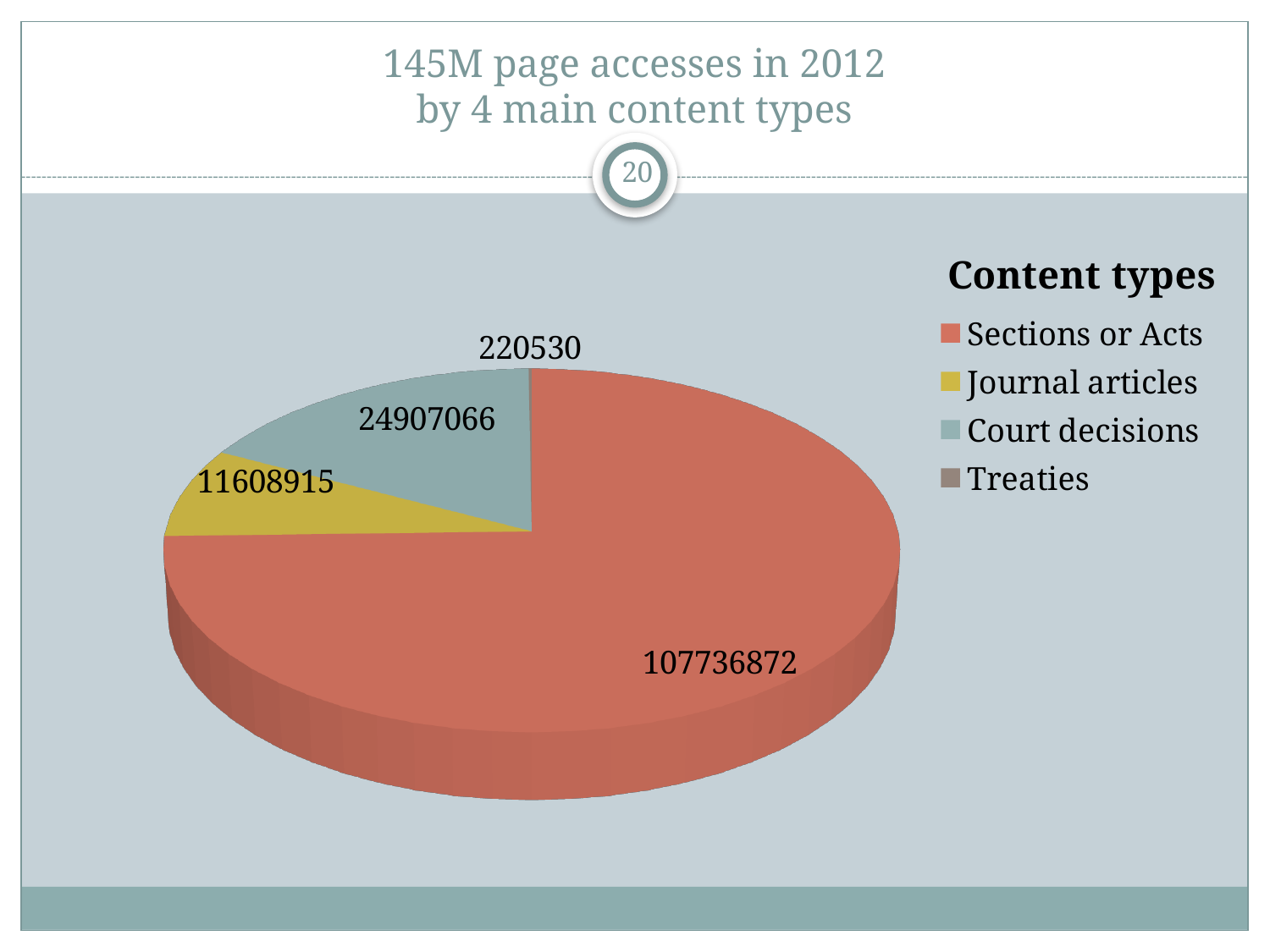
What is the value shown for Court decisions? 24907066 What is the value shown for Journal articles? 11608915 What kind of chart is shown on the slide? pie chart What colour is the slice for Sections or Acts? red What is the value shown for Treaties? 220530 Which content type has the smallest slice of the pie? Treaties What is the title of the chart's legend? Content types How many content types are shown in the pie chart? 4 What is the value shown for Sections or Acts? 107736872 Which is larger, Court decisions or Journal articles? Court decisions Which content type has the largest slice of the pie? Sections or Acts What is the difference between the values for Sections or Acts and Court decisions? 82829806